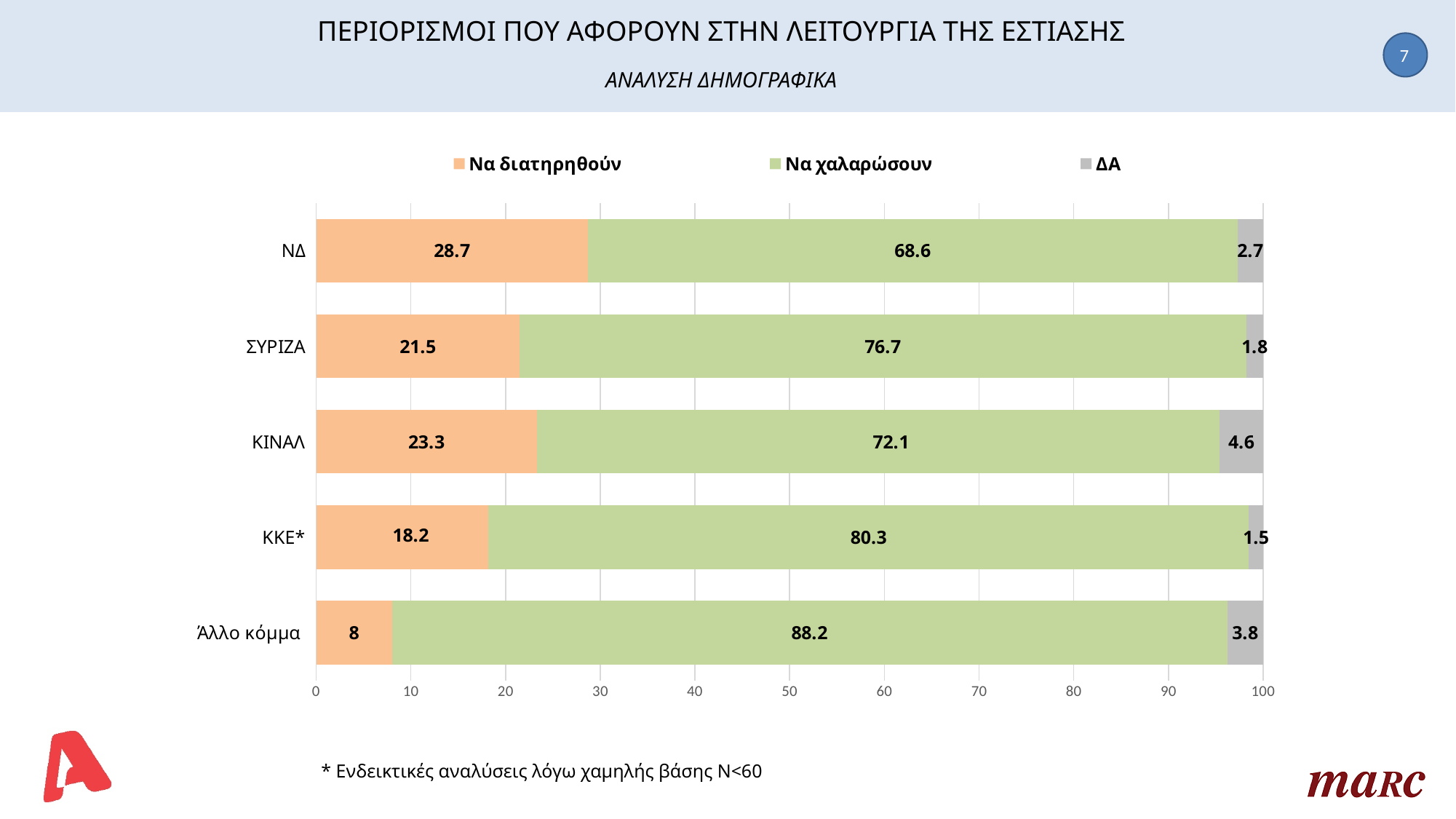
What kind of chart is shown on the slide? Stacked bar chart What is the value of "ΔΑ" for ΚΙΝΑΛ? 4.6 What is the value of "Να χαλαρώσουν" for ΣΥΡΙΖΑ? 76.7 How many series does the legend list? 3 Which category has the highest value for "Να χαλαρώσουν"? Άλλο κόμμα What is the value of "Να διατηρηθούν" for ΝΔ? 28.7 What is the difference between the "Να χαλαρώσουν" values for ΚΚΕ* and ΝΔ? 11.7 What is the total of the stacked bar for ΚΚΕ*? 100 Which series is shown in green? Να χαλαρώσουν Which is larger: the "Να διατηρηθούν" value for ΣΥΡΙΖΑ or for ΚΙΝΑΛ? ΚΙΝΑΛ Which category has the lowest value for "Να διατηρηθούν"? Άλλο κόμμα How many categories are shown on the y axis? 5